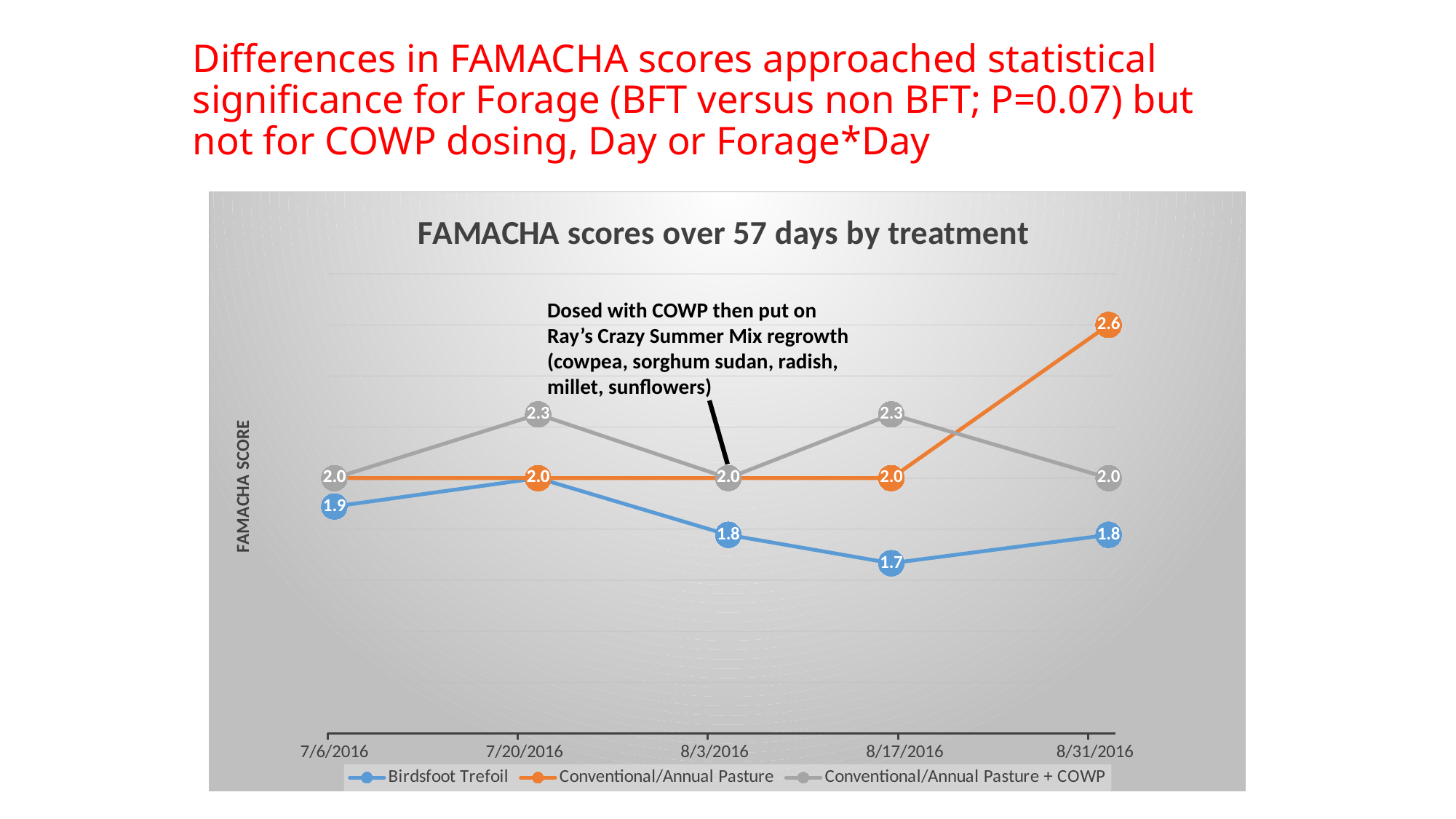
What is the FAMACHA score for Conventional/Annual Pasture + COWP on 7/20/2016? 2.3 How many dates are plotted along the x axis? 5 What is the difference between the Conventional/Annual Pasture score and the Birdsfoot Trefoil score on 8/31/2016? 0.8 What is the FAMACHA score for Birdsfoot Trefoil on 8/17/2016? 1.7 How many series does the legend list? 3 What is the FAMACHA score for Birdsfoot Trefoil on 7/6/2016? 1.9 On which date does Conventional/Annual Pasture reach its highest FAMACHA score? 8/31/2016 What is the title of the chart? FAMACHA scores over 57 days by treatment What type of chart is shown on the slide? line chart On which date does Birdsfoot Trefoil have its lowest FAMACHA score? 8/17/2016 What is the FAMACHA score for Conventional/Annual Pasture on 8/31/2016? 2.6 On 8/17/2016, which series has the higher FAMACHA score: Birdsfoot Trefoil or Conventional/Annual Pasture + COWP? Conventional/Annual Pasture + COWP